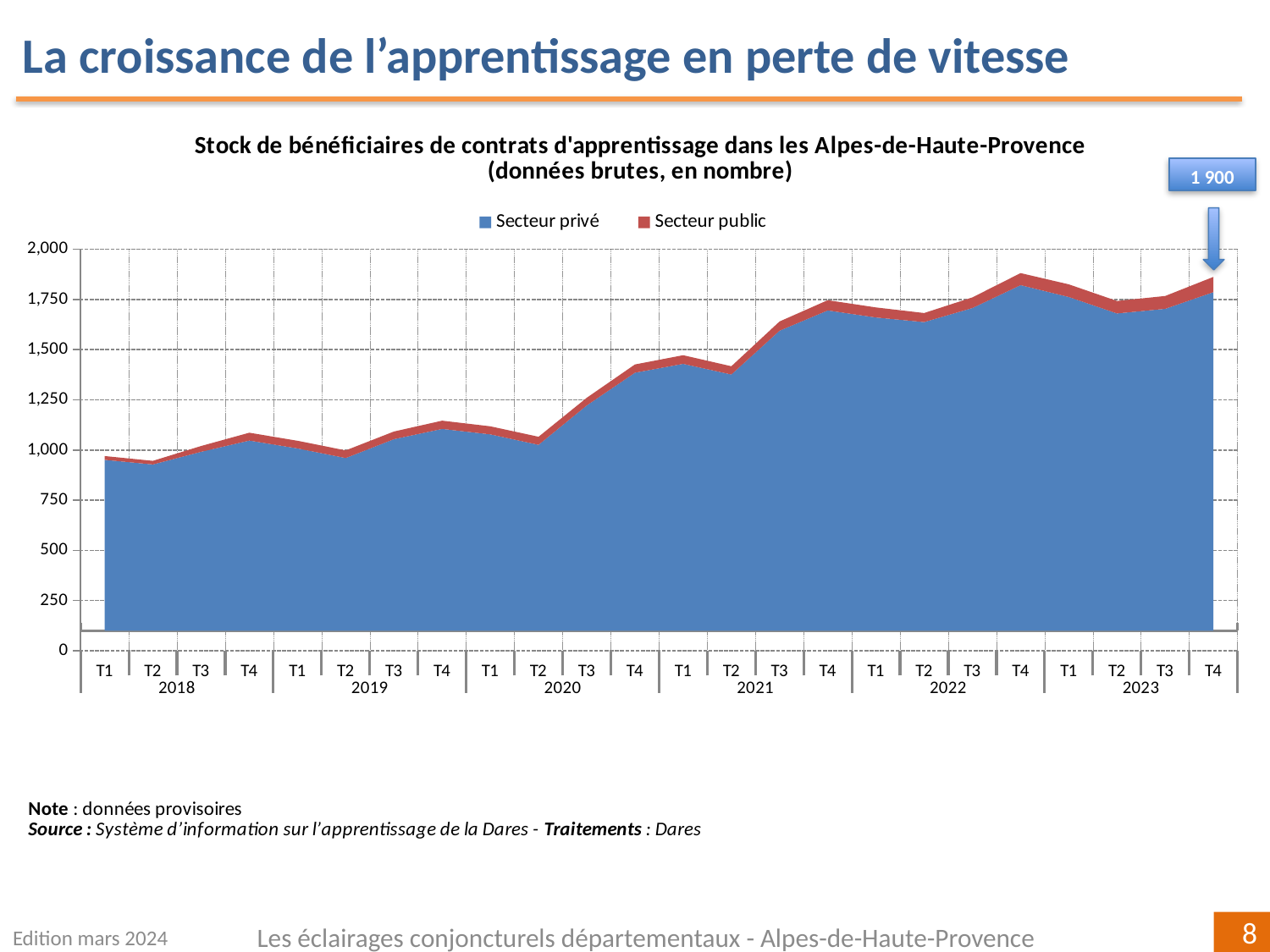
Which series accounts for the larger part of the stock in every quarter, Secteur privé or Secteur public? Secteur privé What kind of chart is shown on the slide? Stacked area chart Overall, do the values rise or fall from T1 2018 to T4 2023? Rise Is the total value for T4 2022 greater or less than 1,750? greater How many quarterly data points are plotted along the x axis? 24 Is the total value for T2 2020 greater or less than 1,250? less What are the two series named in the legend? Secteur privé and Secteur public Is the total value for T3 2021 greater or less than 1,500? greater Which is larger, the total for T4 2021 or the total for T2 2020? T4 2021 What total value is indicated by the callout for T4 2023? 1 900 How many series does the legend list? 2